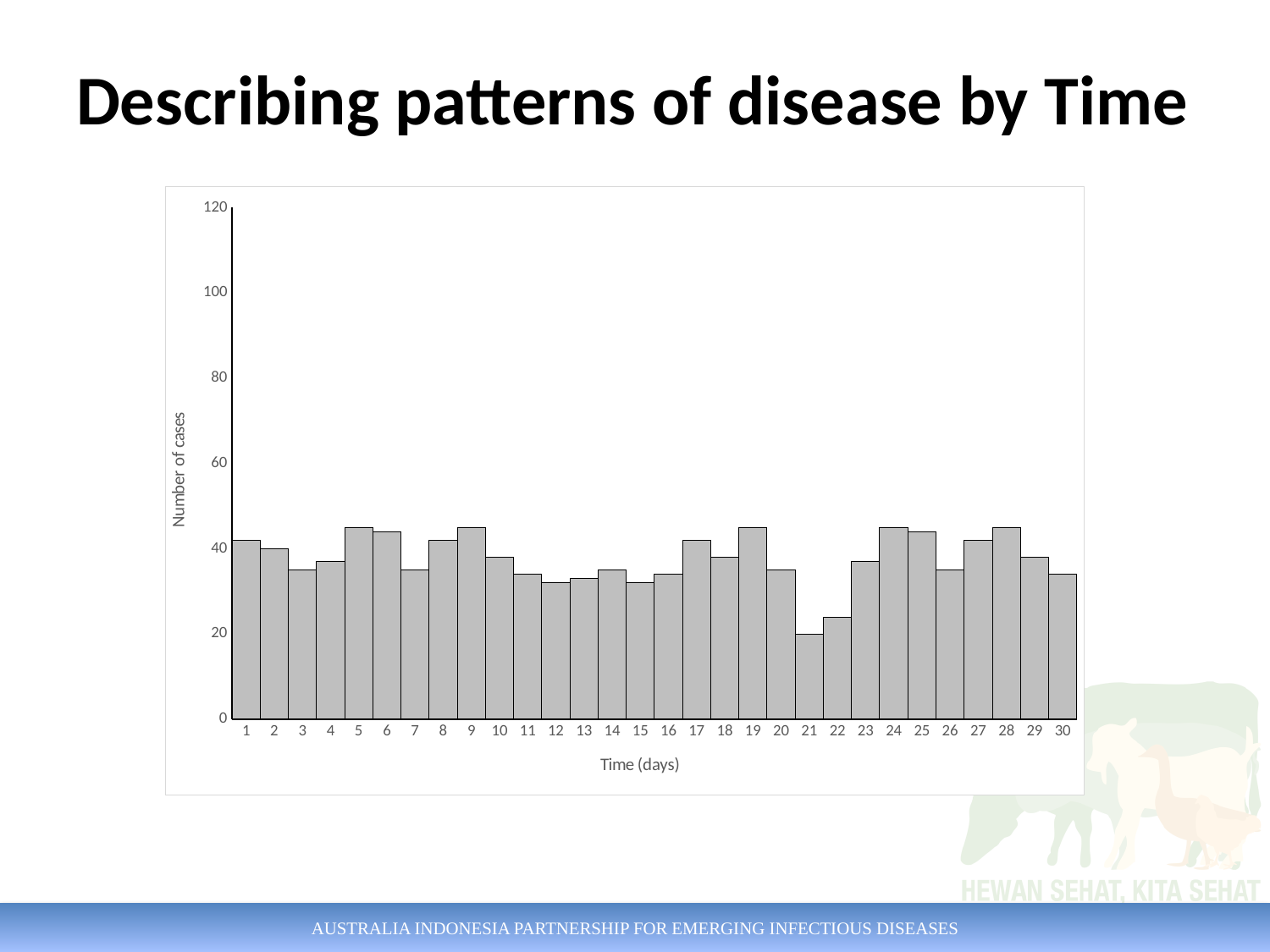
Is the number of cases on day 1 greater or less than 20? greater How many days are plotted along the x axis of the chart? 30 Is the number of cases on day 21 greater or less than 40? less Is the number of cases on day 5 greater or less than 40? greater Which day has the lowest number of cases? 21 What is the label on the vertical axis of the chart? Number of cases What kind of chart is shown on the slide? bar chart Which day has more cases, day 21 or day 22? day 22 Do the number of cases rise or fall from day 19 to day 21? fall Which day has more cases, day 5 or day 21? day 5 What is the label on the horizontal axis of the chart? Time (days)